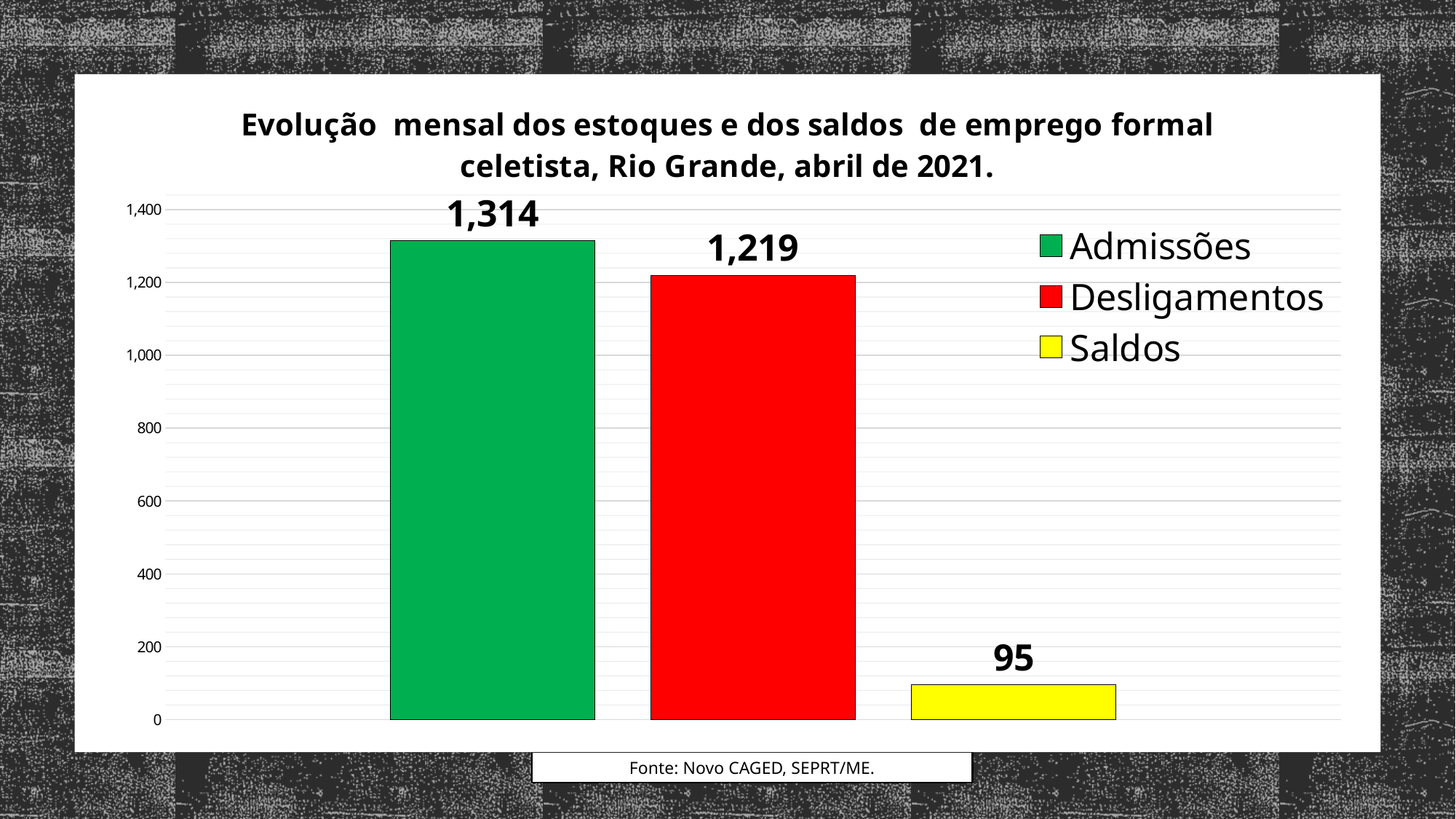
How many series does the legend list? 3 What colour is the bar for Saldos? yellow Which series has the lowest value? Saldos What is the value for Admissões? 1,314 Which series has the highest value? Admissões What is the difference between Admissões and Desligamentos? 95 Is the value for Desligamentos greater or less than 1,200? greater What source is cited below the chart? Novo CAGED, SEPRT/ME. What kind of chart is shown on the slide? bar chart What is the value for Saldos? 95 Which is larger, Admissões or Desligamentos? Admissões What is the value for Desligamentos? 1,219